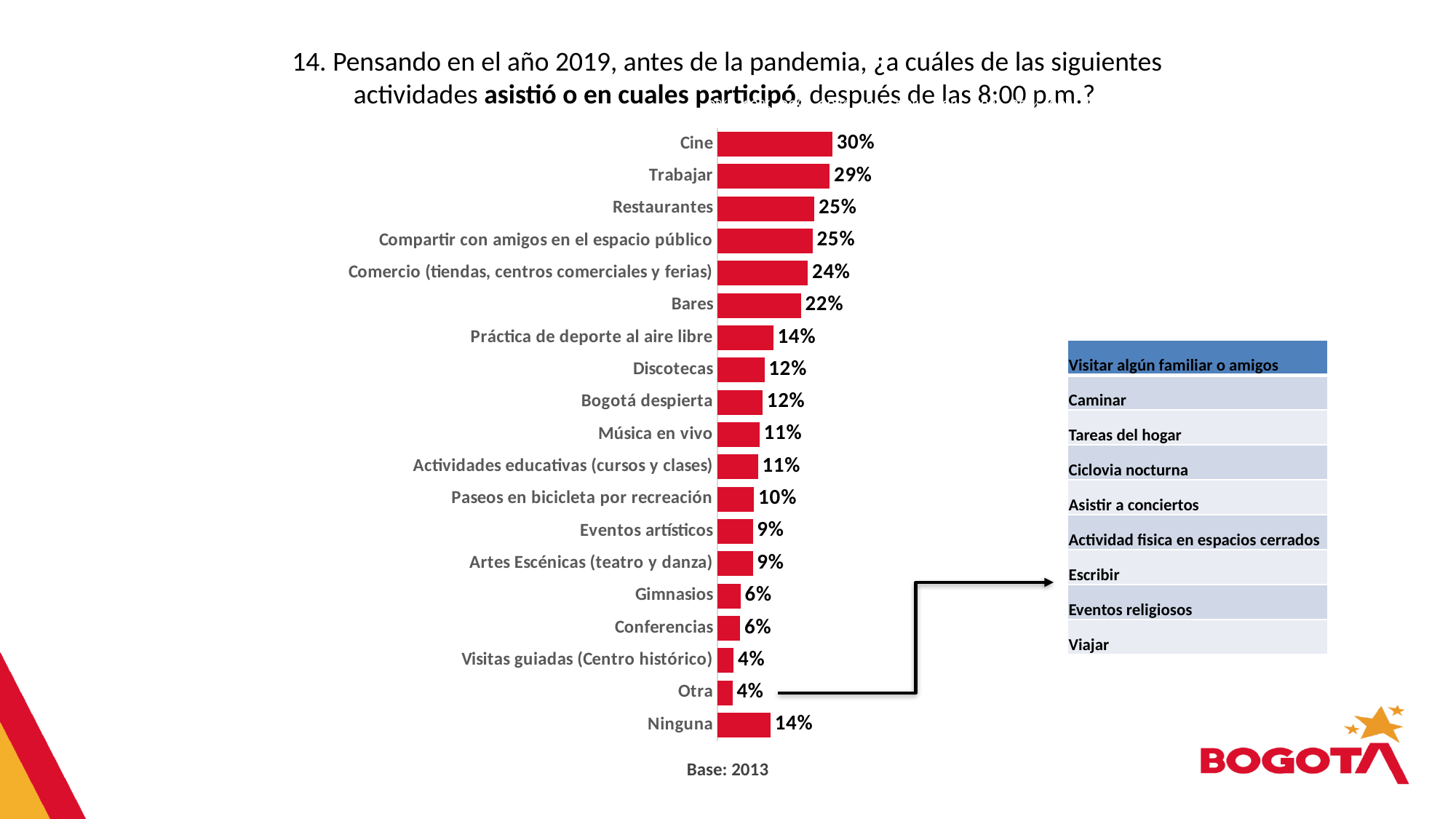
What is the difference between the values for Cine and Trabajar? 1% What kind of chart is shown on the slide? Bar chart What is the base (sample size) stated below the chart? Base: 2013 What is the difference between the values for Bares and Discotecas? 10% What is the value for Bares? 22% What is the value for Gimnasios? 6% Which is larger, the value for Práctica de deporte al aire libre or the value for Música en vivo? Práctica de deporte al aire libre Which is larger, the value for Restaurantes or the value for Comercio (tiendas, centros comerciales y ferias)? Restaurantes Which category has the highest value? Cine How many categories are shown in the bar chart? 19 What is the value for Cine? 30% What is the value for Ninguna? 14%